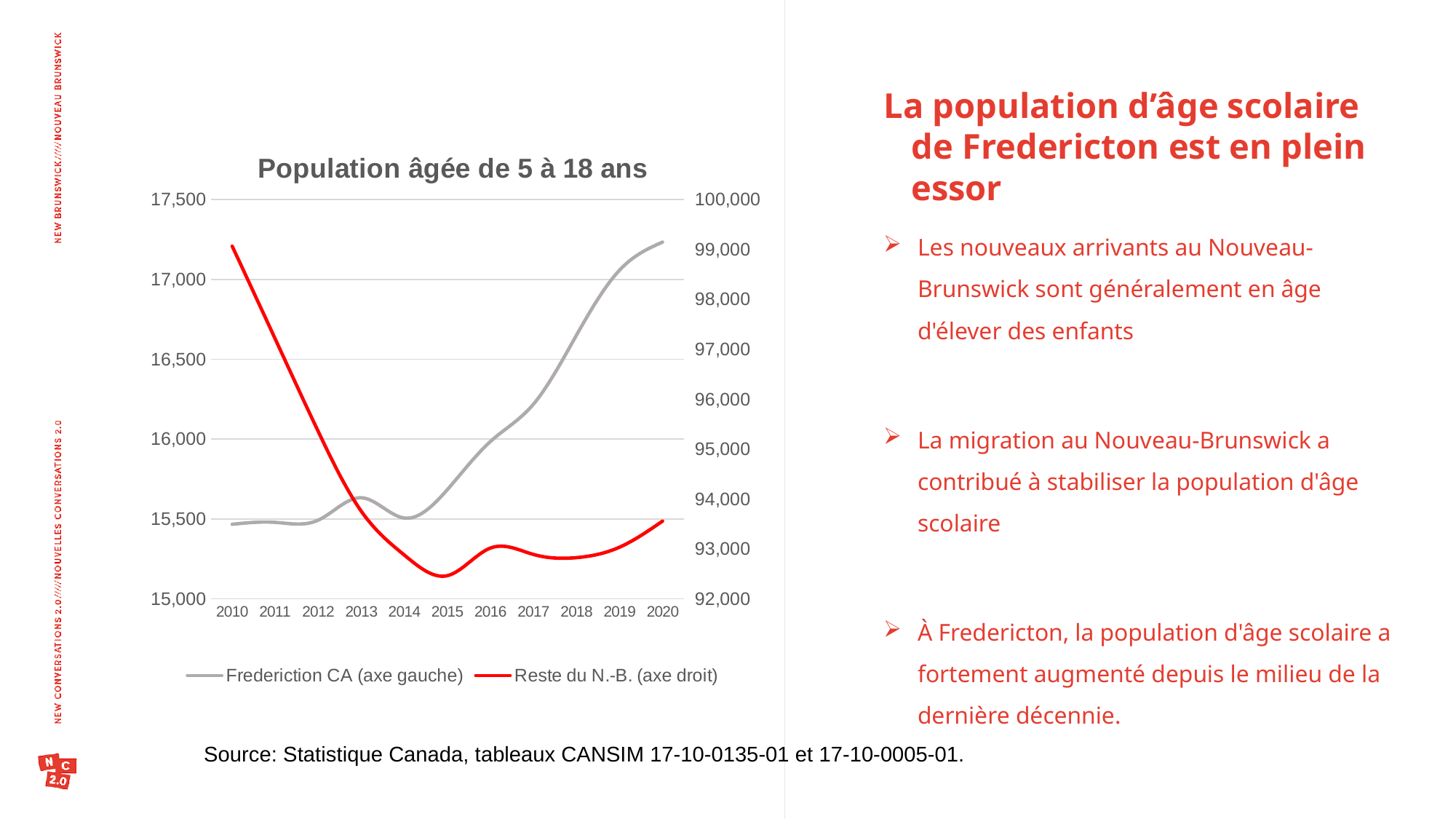
Which series is drawn in red? Reste du N.-B. (axe droit) In which year is the Fredericton CA series at its highest? 2020 How many series does the chart legend list? 2 Does the Reste du N.-B. series rise or fall between 2010 and 2015? fall Is the value for Fredericton CA in 2010 greater or less than 16,000? less How many years are shown on the x axis of the chart? 11 Is the value for Reste du N.-B. in 2010 greater or less than 98,000? greater In which year is the Reste du N.-B. series at its highest? 2010 Is the value for Fredericton CA in 2020 greater or less than 17,000? greater What kind of chart is shown on the slide? line chart In which year is the Reste du N.-B. series at its lowest? 2015 What is the title of the chart? Population âgée de 5 à 18 ans